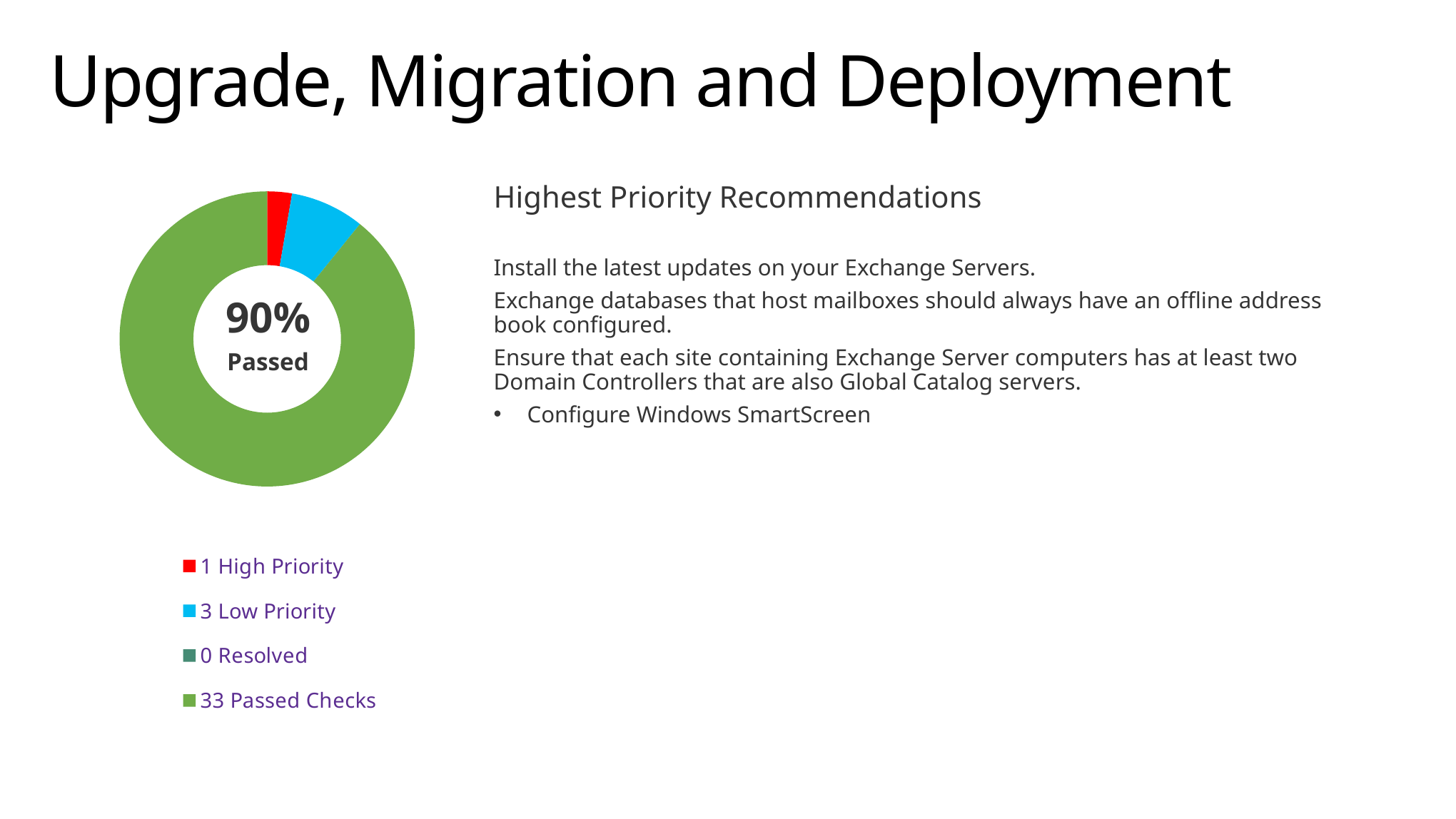
What type of chart is shown on the slide? Pie chart (donut) Which is larger, the number of Low Priority items or the number of High Priority items? Low Priority Which category has the smallest value in the chart? Resolved What percentage of checks passed, according to the text in the centre of the chart? 90% What colour represents Passed Checks in the chart? Green How many High Priority items does the legend show? 1 How many categories does the chart's legend list? 4 Which category has the largest value in the chart? Passed Checks What is the difference between the number of Passed Checks and the number of Low Priority items? 30 How many Resolved items does the legend show? 0 How many Low Priority items does the legend show? 3 How many Passed Checks does the legend show? 33